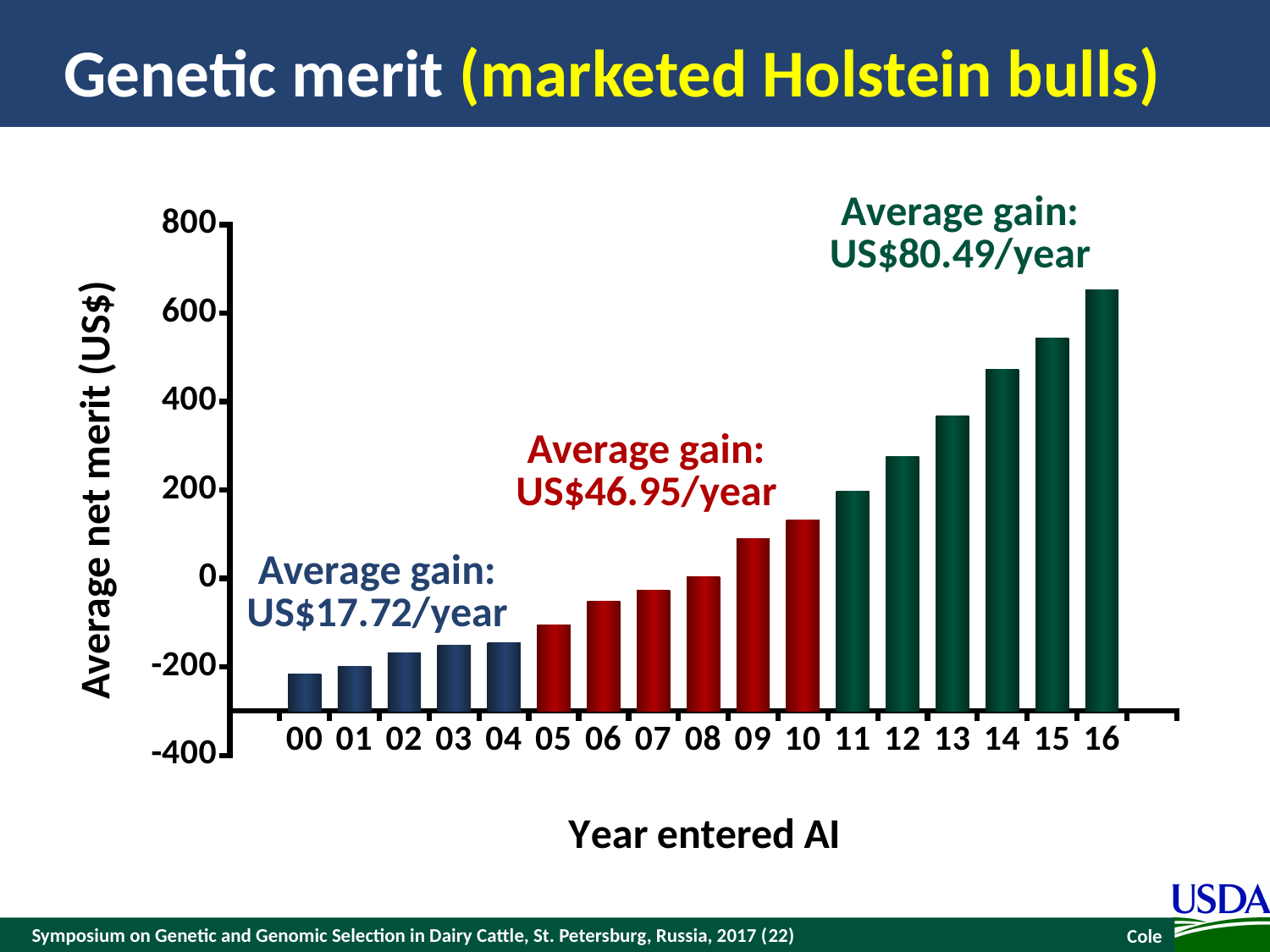
Which year entered AI has the highest average net merit? 16 Is the average net merit for year 00 greater or less than -200? less What is the label of the y axis? Average net merit (US$) Is the average net merit for year 16 greater or less than 600? greater Which year has a larger average net merit, 10 or 12? 12 What kind of chart is shown on the slide? Bar chart Which year entered AI has the lowest average net merit? 00 Which year has a larger average net merit, 05 or 07? 07 Is the average net merit for year 13 greater or less than 400? less Do the average net merit values rise or fall from year 00 to year 16? Rise How many years (bars) are plotted on the x axis? 17 What average gain per year is annotated for the green bars (years 11 to 16)? US$80.49/year